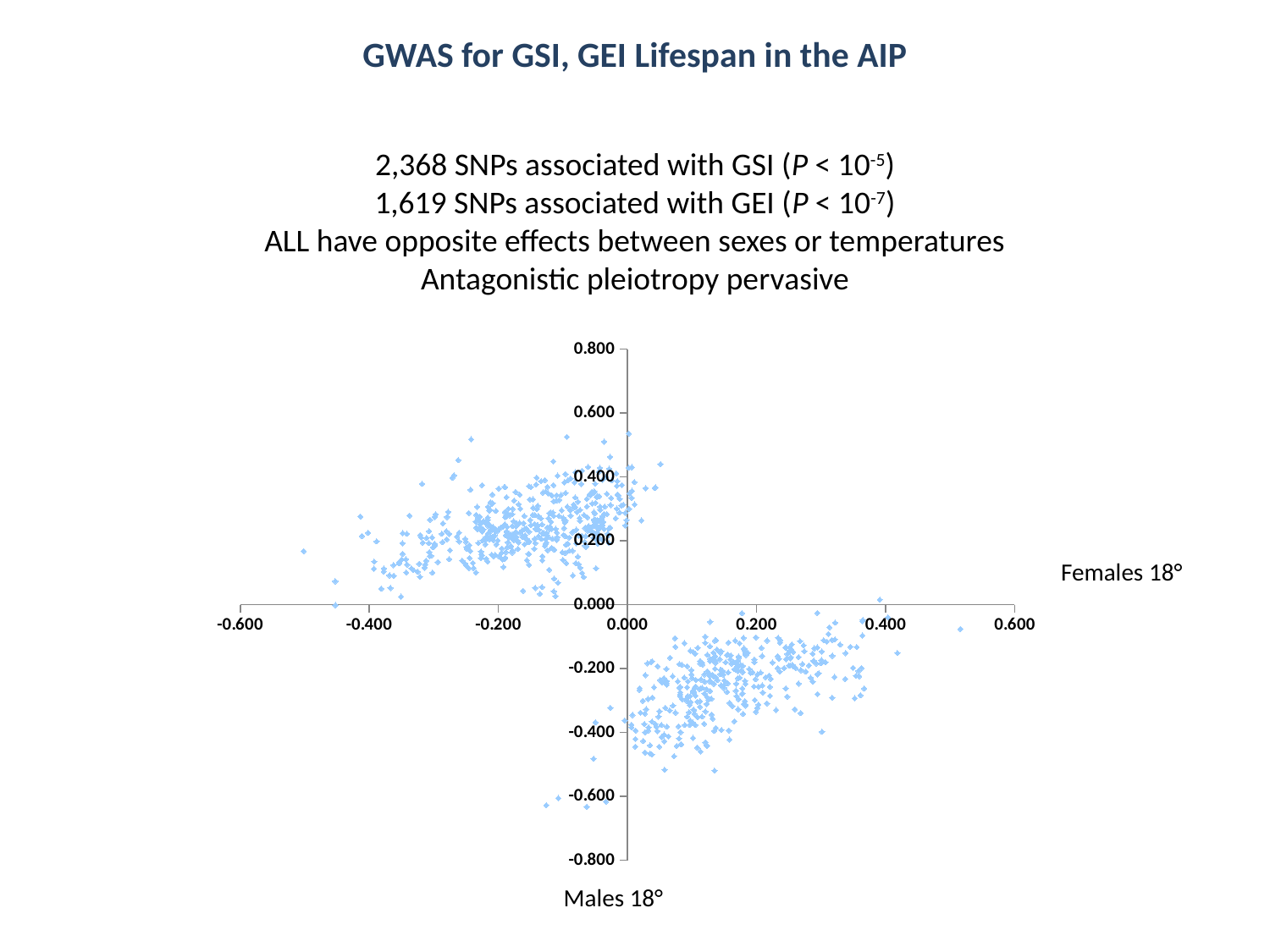
What is the title of the slide containing the chart? GWAS for GSI, GEI Lifespan in the AIP What is the highest tick value shown on the vertical axis of the chart? 0.800 Are the points with negative Males 18° values mostly above or below 0.000 on the Females 18° axis? above What is the lowest tick value shown on the horizontal axis of the chart? -0.600 What kind of chart is shown on the slide? scatter chart How many distinct clusters of points does the scatter chart show? 2 Are the points with positive Males 18° values mostly above or below 0.000 on the Females 18° axis? below As the values on the x axis (Males 18°) increase, do the plotted points generally rise or fall? fall